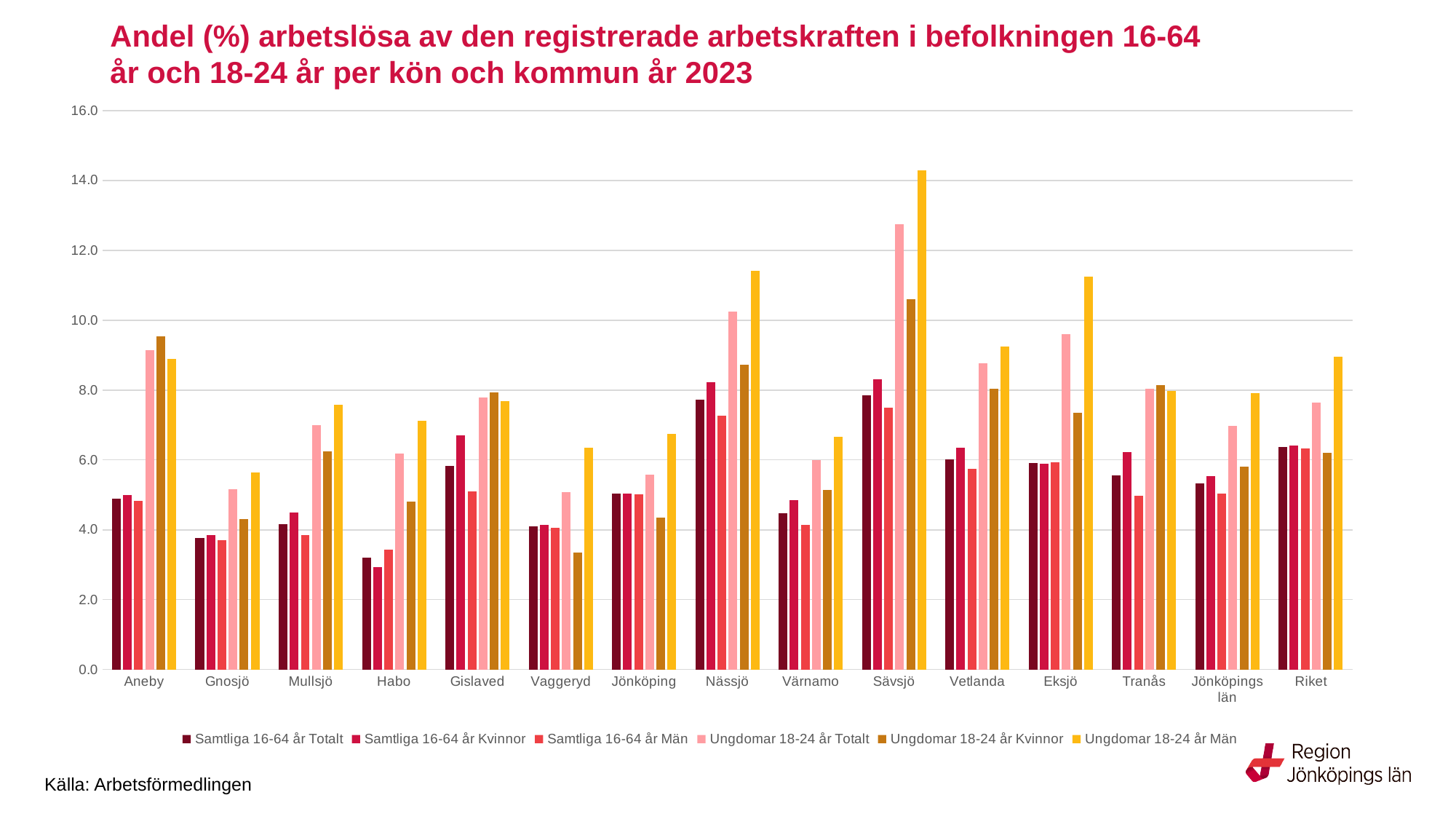
Which series is shown in yellow in the legend? Ungdomar 18-24 år Män How many series does the legend list? 6 Which category has the lowest value for Ungdomar 18-24 år Kvinnor? Vaggeryd Which category has the highest value for Ungdomar 18-24 år Män? Sävsjö How many municipalities/categories are shown along the x axis? 15 Is the value for Ungdomar 18-24 år Kvinnor in Aneby greater or less than 8.0? greater Which is larger: the Ungdomar 18-24 år Män value for Sävsjö or for Gnosjö? Sävsjö Which category has the highest value for Ungdomar 18-24 år Totalt? Sävsjö Is the value for Ungdomar 18-24 år Män in Eksjö greater or less than 10.0? greater Which category has the lowest value for Samtliga 16-64 år Män? Habo What kind of chart is shown on the slide? bar chart Is the value for Samtliga 16-64 år Totalt in Habo greater or less than 4.0? less